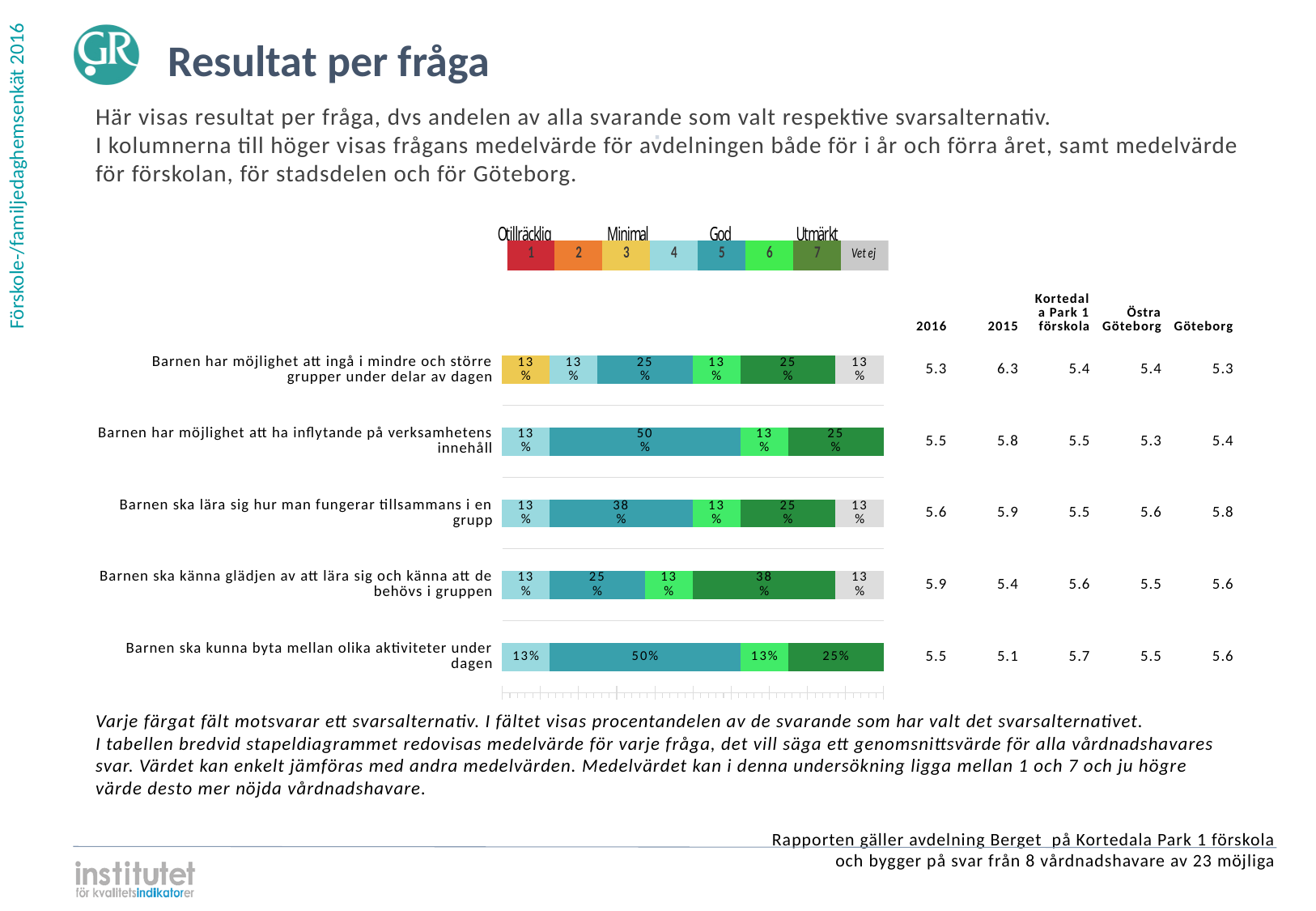
What are the four scale labels shown above the legend of the chart? Otillräcklig, Minimal, God, Utmärkt How many questions (bars) are plotted in the chart? 5 What percentage is shown for the dark green segment in the bar for "Barnen ska känna glädjen av att lära sig och känna att de behövs i gruppen"? 38% What is the largest segment value in the bar for "Barnen ska kunna byta mellan olika aktiviteter under dagen"? 50% What percentage is shown for the grey "Vet ej" segment in the bar for "Barnen har möjlighet att ingå i mindre och större grupper under delar av dagen"? 13% In the bar for "Barnen ska känna glädjen av att lära sig och känna att de behövs i gruppen", what is the difference between the dark green segment (38%) and the teal segment (25%)? 13 percentage points How many numbered rating levels does the chart legend show, excluding "Vet ej"? 7 What kind of chart is shown on the slide? Stacked bar chart What percentage is shown for the yellow segment in the bar for "Barnen har möjlighet att ingå i mindre och större grupper under delar av dagen"? 13% How many coloured segments make up the bar for "Barnen har möjlighet att ingå i mindre och större grupper under delar av dagen"? 6 What percentage is shown for the teal segment in the bar for "Barnen ska lära sig hur man fungerar tillsammans i en grupp"? 38% In the bar for "Barnen ska känna glädjen av att lära sig och känna att de behövs i gruppen", which is larger: the teal segment or the dark green segment? The dark green segment